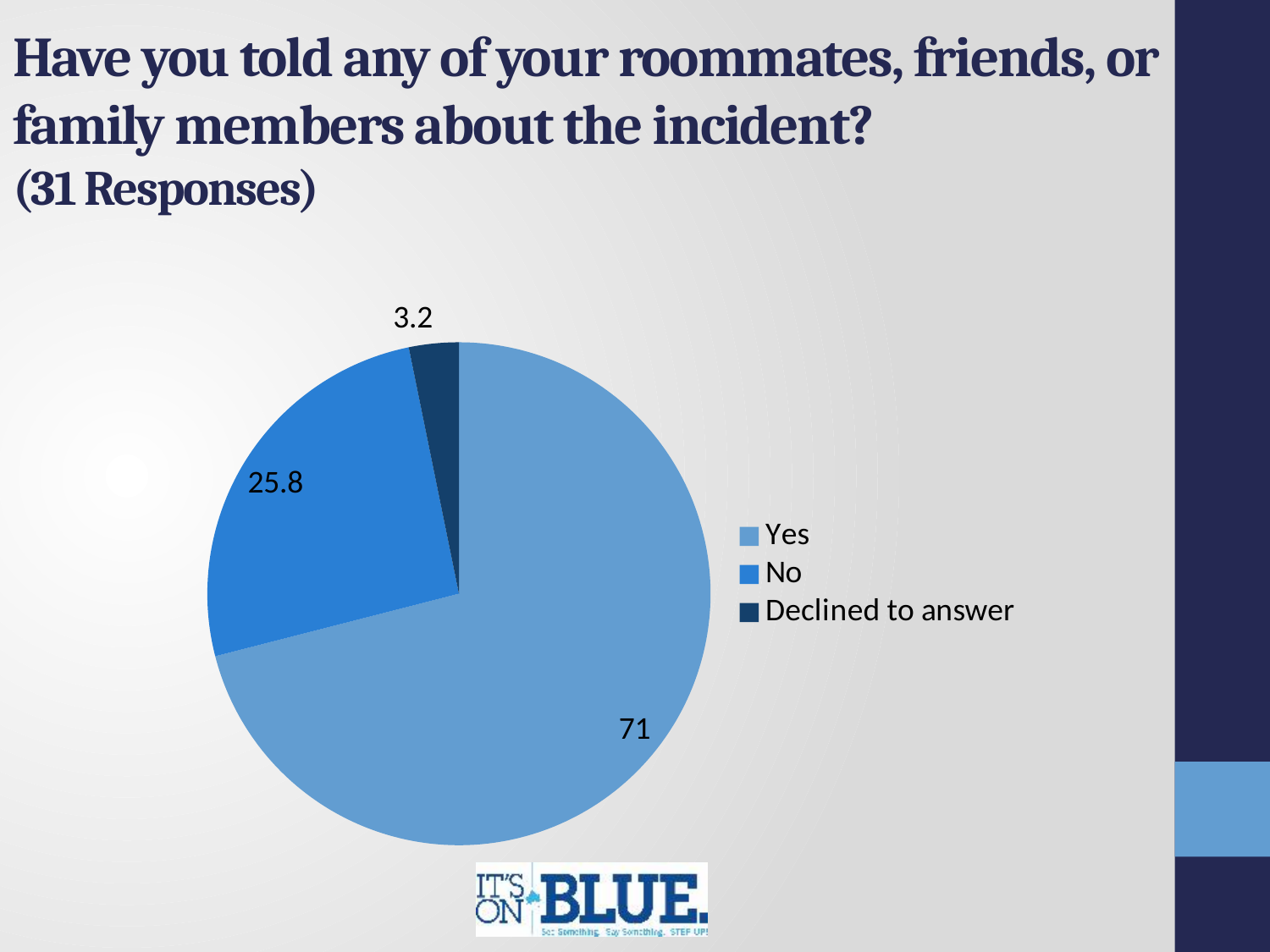
Which category has the largest slice of the pie? Yes What is the difference between the Yes value and the No value? 45.2 What kind of chart is shown on the slide? pie chart What is the value shown for the Yes slice? 71 How many categories does the legend list? 3 How many responses does the slide say the chart is based on? 31 Which is larger, the No slice or the Declined to answer slice? No Which legend entry is shown in the darkest blue? Declined to answer What is the value shown for the Declined to answer slice? 3.2 Which category has the smallest slice of the pie? Declined to answer What is the value shown for the No slice? 25.8